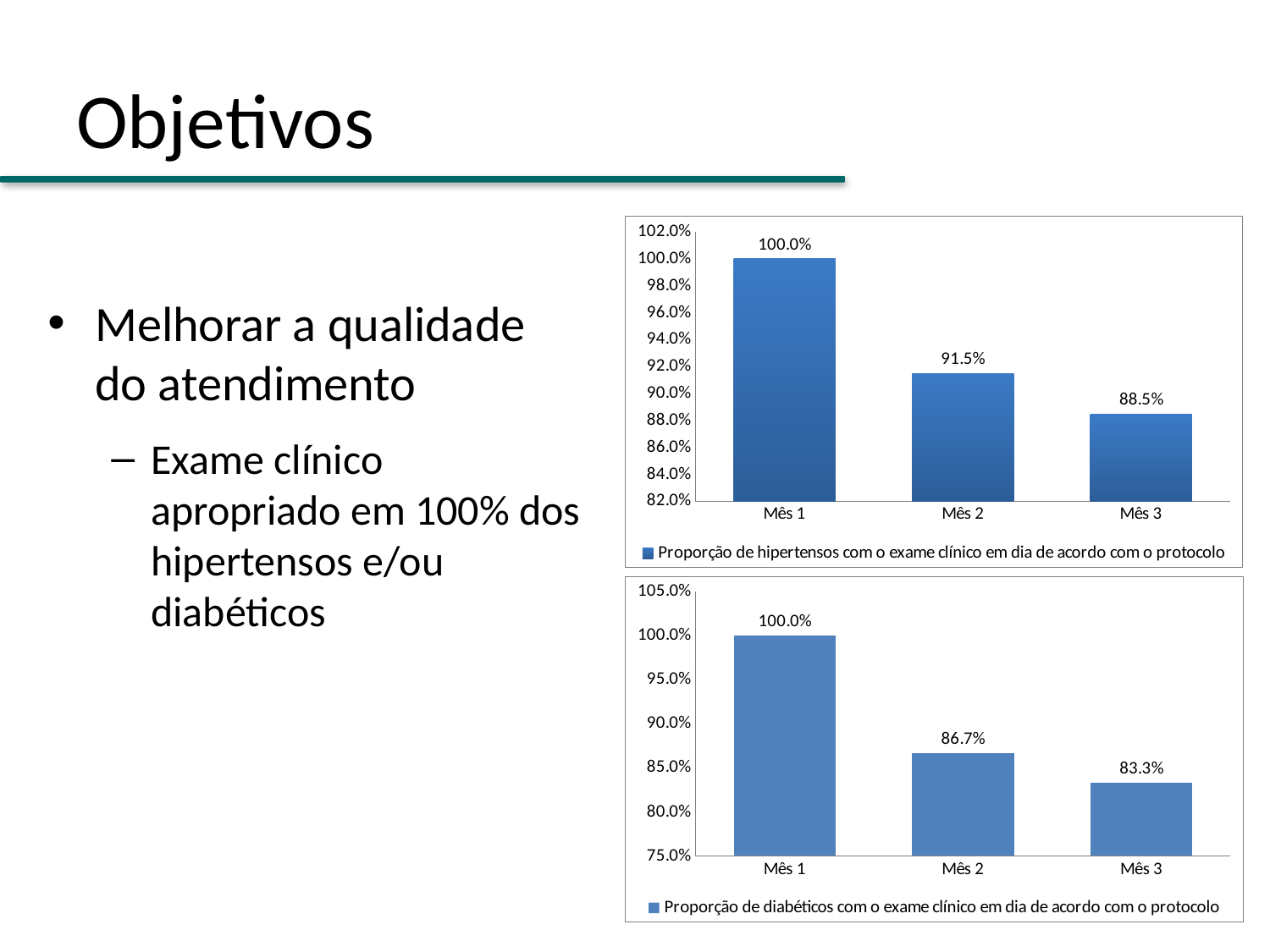
In the top chart (Proporção de hipertensos com o exame clínico em dia de acordo com o protocolo), what is the value for Mês 2? 91.5% In the top chart (Proporção de hipertensos com o exame clínico em dia de acordo com o protocolo), what is the difference between the values for Mês 1 and Mês 3? 11.5% What kind of chart is the bottom chart (Proporção de diabéticos com o exame clínico em dia de acordo com o protocolo)? Bar chart In the top chart (Proporção de hipertensos com o exame clínico em dia de acordo com o protocolo), which month has the highest value? Mês 1 In the bottom chart (Proporção de diabéticos com o exame clínico em dia de acordo com o protocolo), which month has the lowest value? Mês 3 In the bottom chart (Proporção de diabéticos com o exame clínico em dia de acordo com o protocolo), which is larger, the value for Mês 2 or Mês 3? Mês 2 In the bottom chart (Proporção de diabéticos com o exame clínico em dia de acordo com o protocolo), what is the value for Mês 2? 86.7% In the bottom chart (Proporção de diabéticos com o exame clínico em dia de acordo com o protocolo), what is the difference between the values for Mês 2 and Mês 3? 3.4% In the top chart (Proporção de hipertensos com o exame clínico em dia de acordo com o protocolo), do the values rise or fall from Mês 1 to Mês 3? Fall How many months are shown on the x axis of the top chart (Proporção de hipertensos com o exame clínico em dia de acordo com o protocolo)? 3 In the bottom chart (Proporção de diabéticos com o exame clínico em dia de acordo com o protocolo), what is the value for Mês 3? 83.3% In the top chart (Proporção de hipertensos com o exame clínico em dia de acordo com o protocolo), what is the value for Mês 3? 88.5%